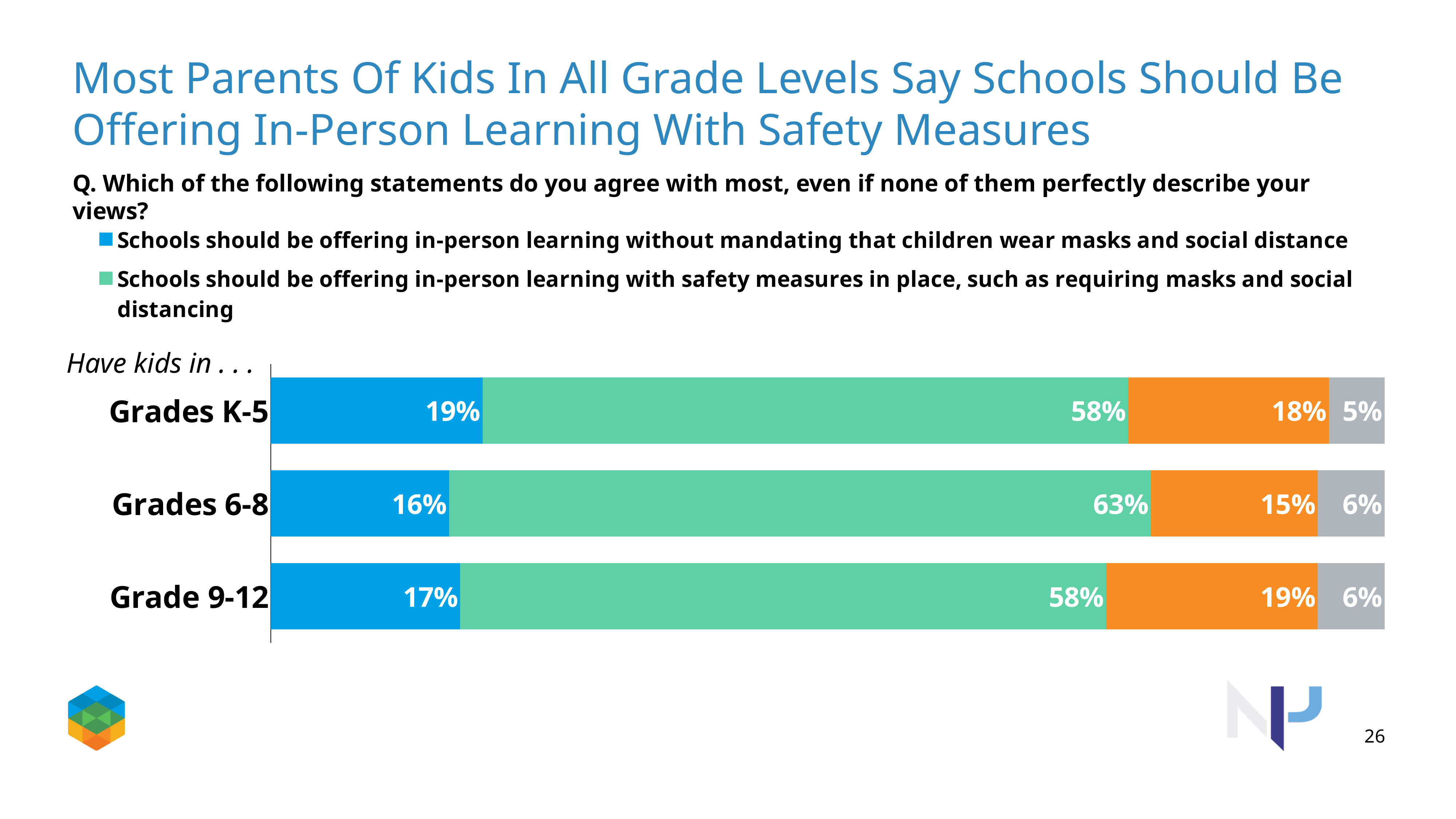
Which group has a larger share saying schools should offer in-person learning without mandating masks: Grades K-5 or Grade 9-12? Grades K-5 How many statements does the legend list? 2 What is the total of all segments in the Grades K-5 bar? 100% What percentage of parents with kids in Grades 6-8 say schools should be offering in-person learning without mandating masks and social distancing? 16% How many percentage points higher is the 'with safety measures' share for Grades 6-8 than for Grades K-5? 5 percentage points What percentage of parents with kids in Grades K-5 say schools should be offering in-person learning with safety measures in place? 58% What kind of chart is shown on the slide? Stacked bar chart Which grade level group has the lowest share saying schools should offer in-person learning without mandating masks and social distancing? Grades 6-8 What percentage of parents with kids in Grade 9-12 say schools should be offering in-person learning with safety measures in place? 58% What percentage of parents with kids in Grade 9-12 say schools should be offering in-person learning without mandating masks and social distancing? 17% How many grade level groups are shown in the chart? 3 Which grade level group has the highest share saying schools should offer in-person learning with safety measures in place? Grades 6-8